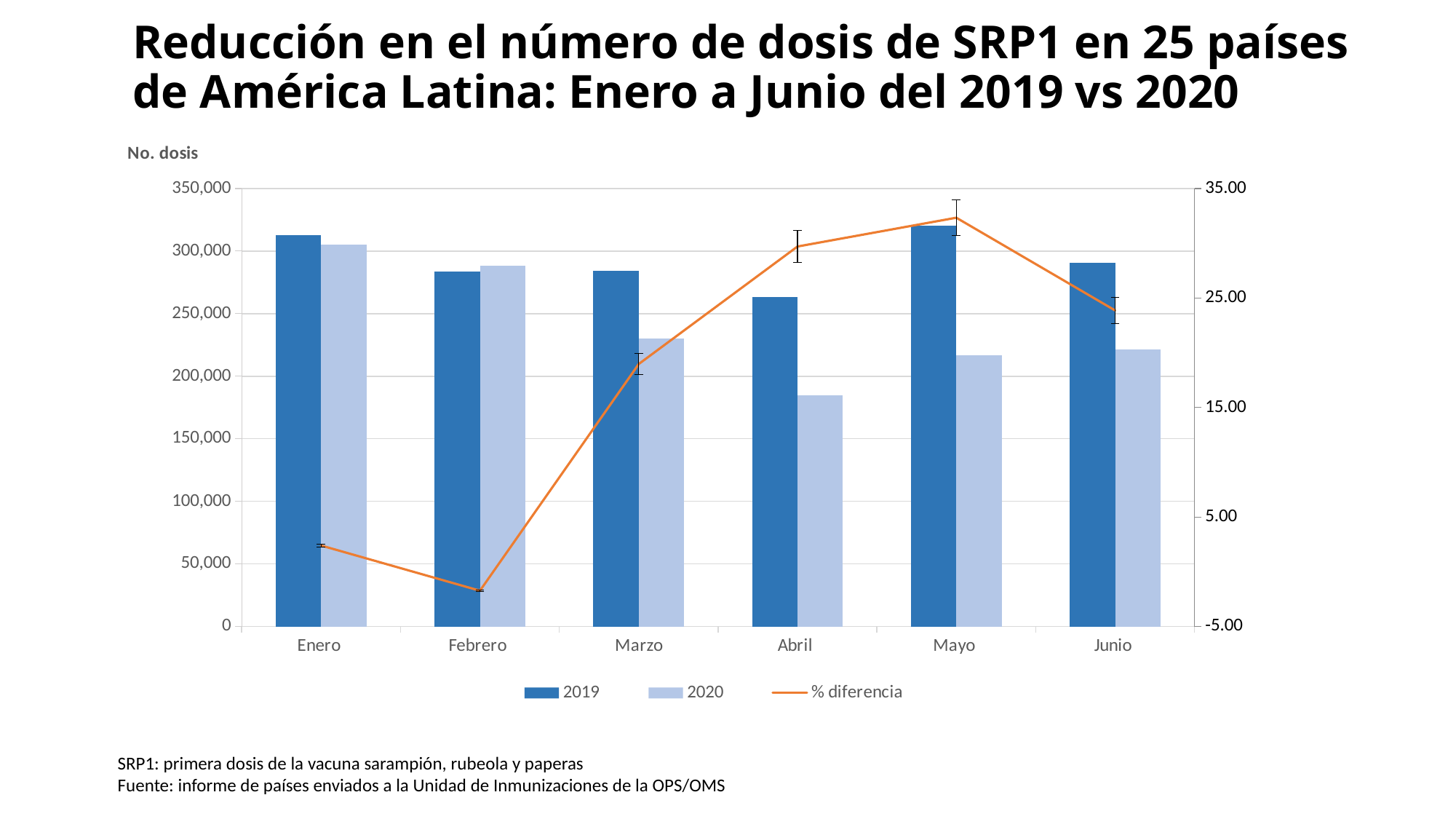
How many series does the chart legend list? 3 What kind of chart is shown on the slide? A combined bar and line chart Which month has the highest 2020 bar? Enero Which month has the highest 2019 bar? Mayo Is the 2020 value for Abril greater or less than 200,000? less In Marzo, which is larger: the 2019 bar or the 2020 bar? 2019 Is the % diferencia value for Abril greater or less than 25.00? greater Do the 2020 bars rise or fall from Enero to Abril? fall Which month has the lowest 2020 bar? Abril Which month has the lowest 2019 bar? Abril Is the 2019 value for Mayo greater or less than 300,000? greater How many months are shown on the x axis of the chart? 6